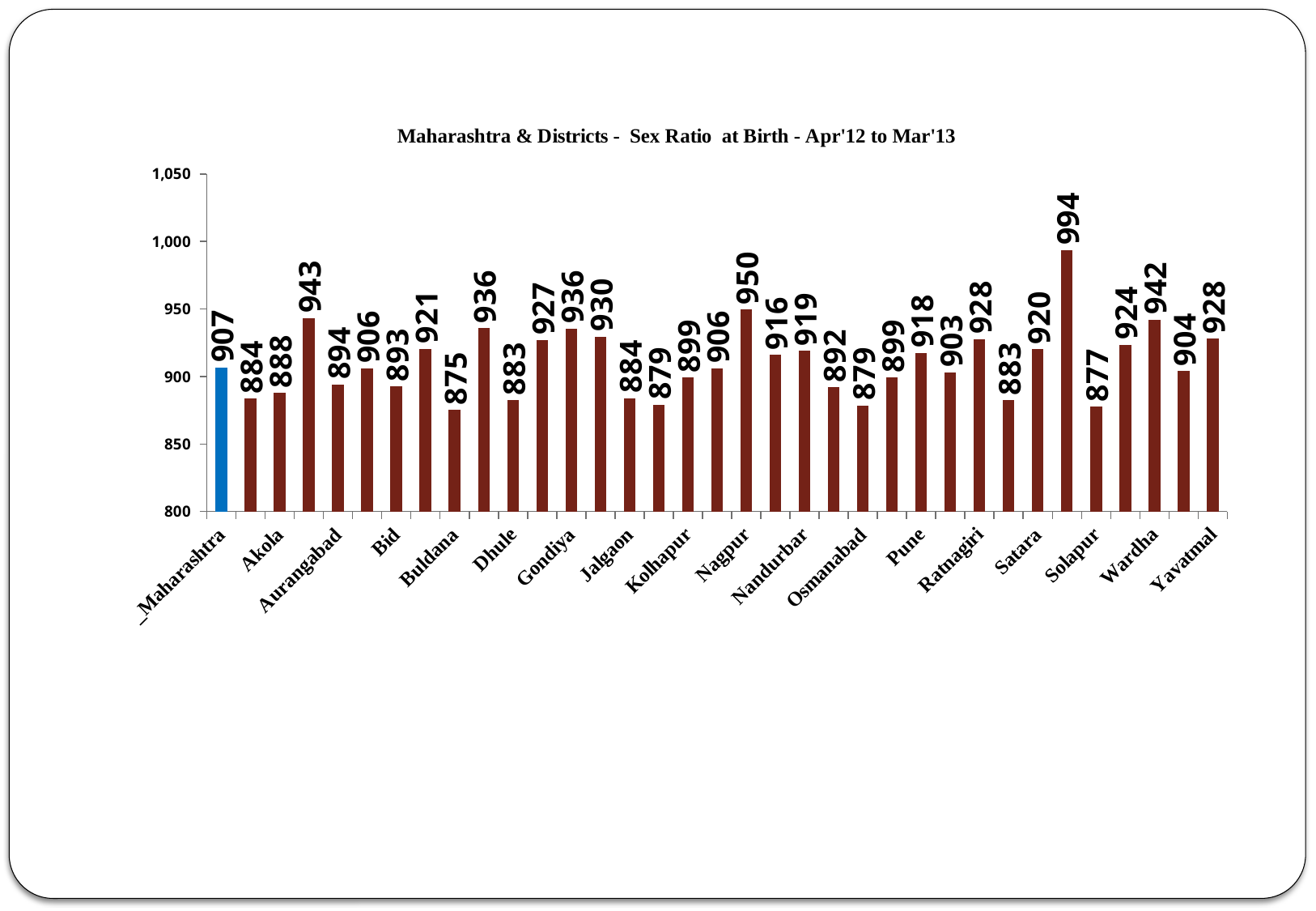
What is the lowest value shown on the chart? 875 What is the difference between the highest value on the chart (994) and the Maharashtra value (907)? 87 Is the value for Maharashtra greater or less than 900? greater What type of chart is shown on the slide? bar chart What is the difference between the highest value (994) and the lowest value (875) on the chart? 119 What is the title of the chart? Maharashtra & Districts - Sex Ratio at Birth - Apr'12 to Mar'13 What colour is the Maharashtra bar, which differs from the other bars? blue What is the maximum value shown on the vertical axis? 1,050 Is the highest bar on the chart greater or less than 950? greater What is the highest value shown on the chart? 994 How many bars on the chart have a value above 950? 1 What is the sex ratio at birth value shown for Maharashtra? 907